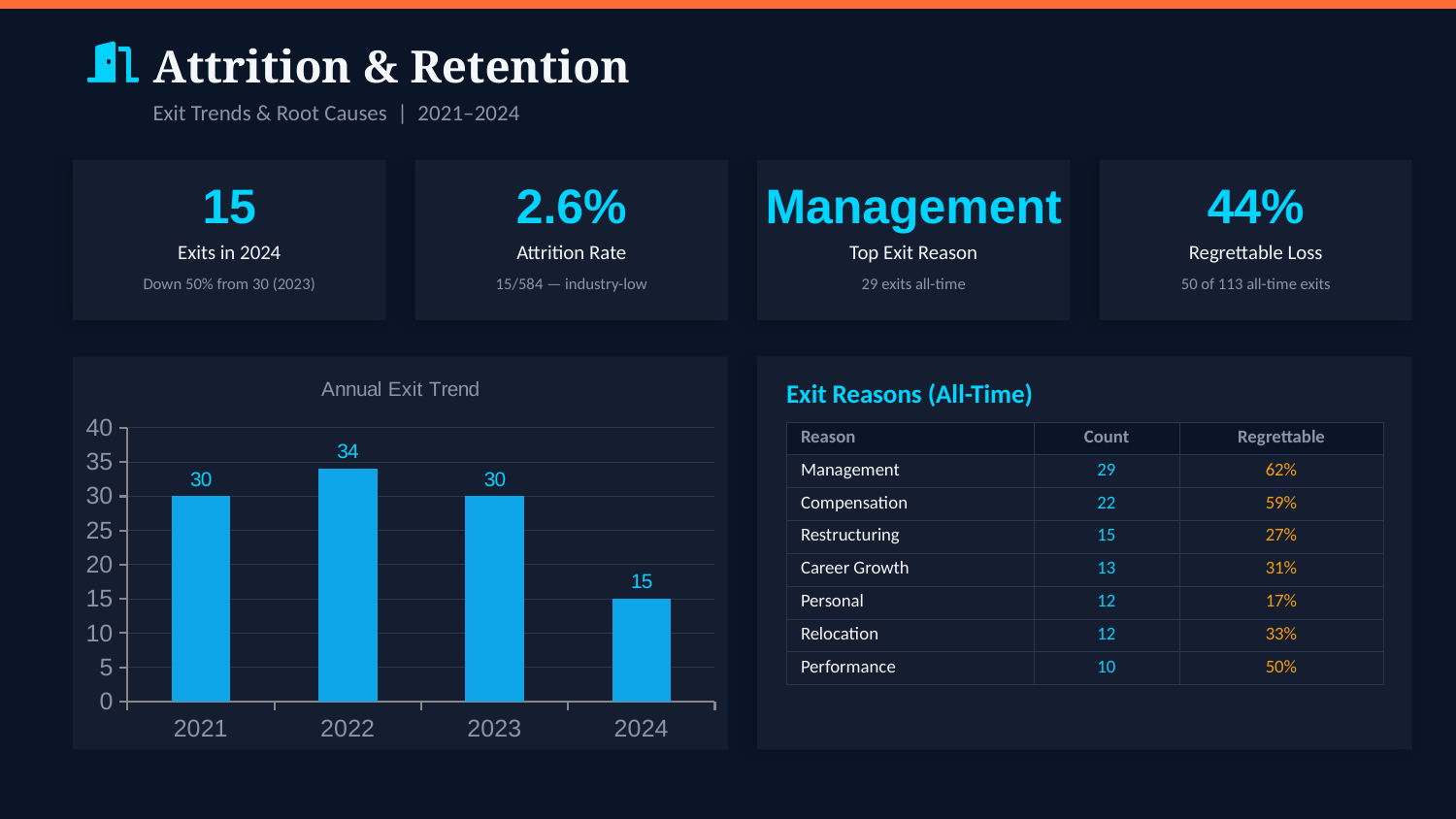
What kind of chart is the Annual Exit Trend chart? bar chart In the Annual Exit Trend chart, which year has the lowest value? 2024 In the Annual Exit Trend chart, is the value for 2024 greater or less than 20? less In the Annual Exit Trend chart, what is the value for 2024? 15 In the Annual Exit Trend chart, what is the difference between the values for 2023 and 2024? 15 In the Annual Exit Trend chart, which year has the highest value? 2022 In the Annual Exit Trend chart, what is the difference between the values for 2022 and 2024? 19 In the Annual Exit Trend chart, what is the value for 2022? 34 How many years are shown on the x axis of the Annual Exit Trend chart? 4 In the Annual Exit Trend chart, do the values rise or fall from 2023 to 2024? fall In the Annual Exit Trend chart, which is larger, the value for 2022 or the value for 2023? 2022 In the Annual Exit Trend chart, what is the value for 2021? 30